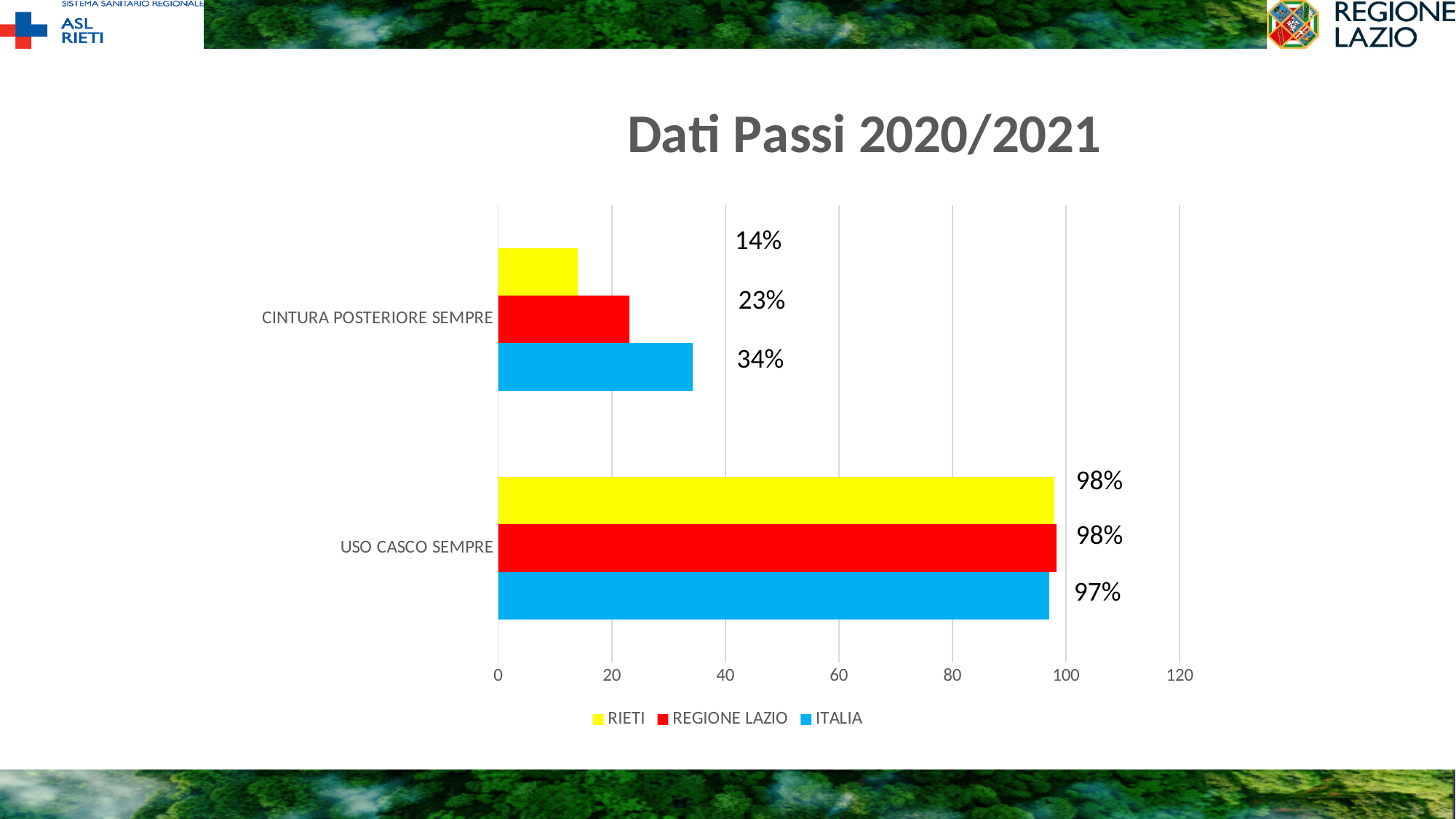
What is the difference between the ITALIA and RIETI values in the CINTURA POSTERIORE SEMPRE category? 20% What is the title of the chart? Dati Passi 2020/2021 Which series has the lowest value in the CINTURA POSTERIORE SEMPRE category? RIETI Which series has the highest value in the CINTURA POSTERIORE SEMPRE category? ITALIA What is the value for REGIONE LAZIO in the CINTURA POSTERIORE SEMPRE category? 23% What kind of chart is shown on the slide? Bar chart Which is larger in the CINTURA POSTERIORE SEMPRE category: REGIONE LAZIO or RIETI? REGIONE LAZIO What is the value for ITALIA in the USO CASCO SEMPRE category? 97% What is the value for ITALIA in the CINTURA POSTERIORE SEMPRE category? 34% How many series does the legend list? 3 What is the value for RIETI in the CINTURA POSTERIORE SEMPRE category? 14% What is the value for RIETI in the USO CASCO SEMPRE category? 98%